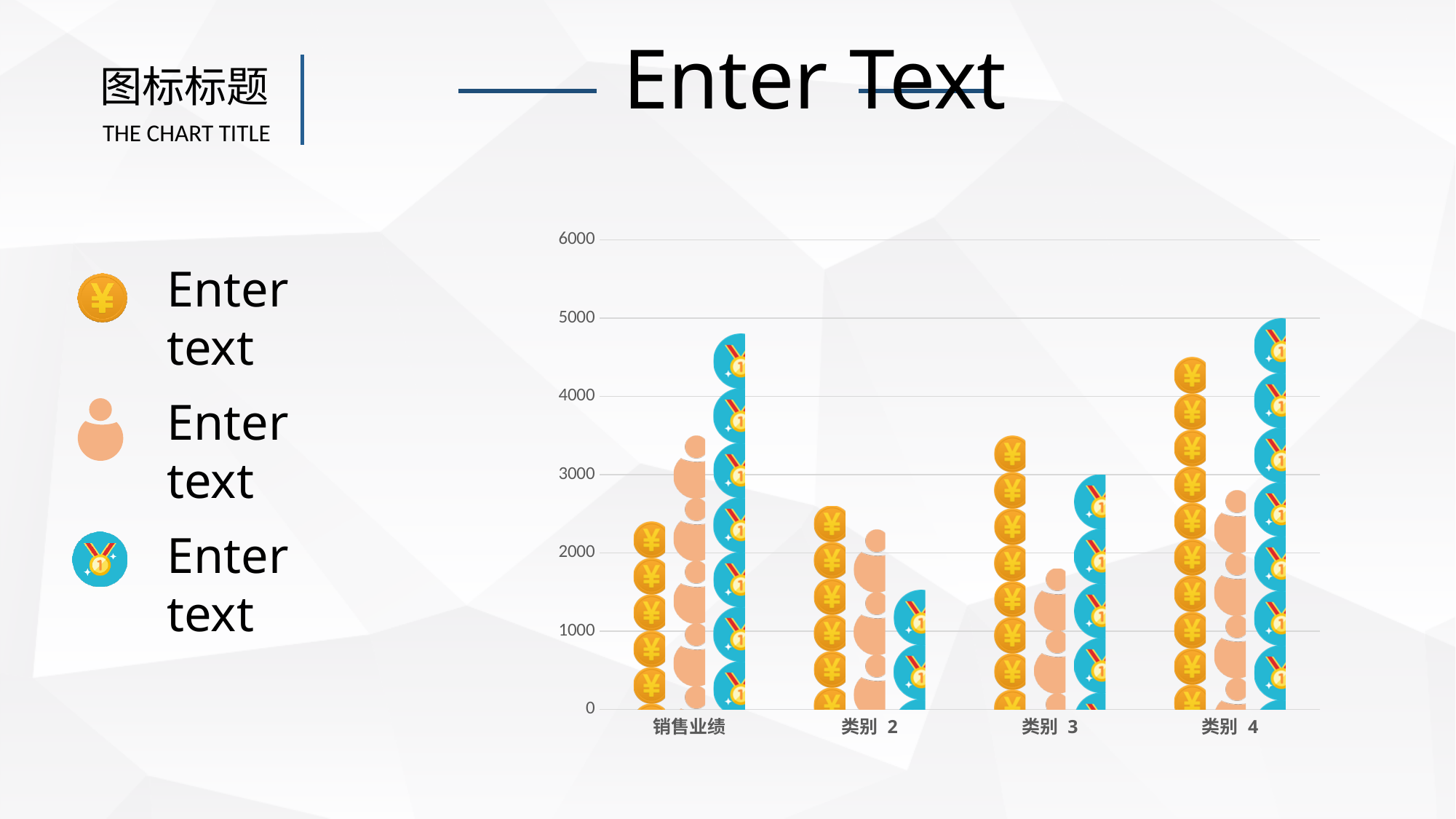
What is the highest value labelled on the vertical axis of the chart? 6000 Which category has the tallest medal-icon bar? 类别 4 Is the value of the coin-icon bar for 类别 3 greater or less than 3000? greater Is the value of the coin-icon bar for 销售业绩 greater or less than 3000? less Is the value of the medal-icon bar for 类别 2 greater or less than 2000? less How many categories are shown on the x axis of the chart? 4 What is the value of the medal-icon bar for 类别 4? 5000 Which category has the shortest medal-icon bar? 类别 2 For 销售业绩, which is taller: the person-icon bar or the coin-icon bar? the person-icon bar What kind of chart is shown on the slide? bar chart